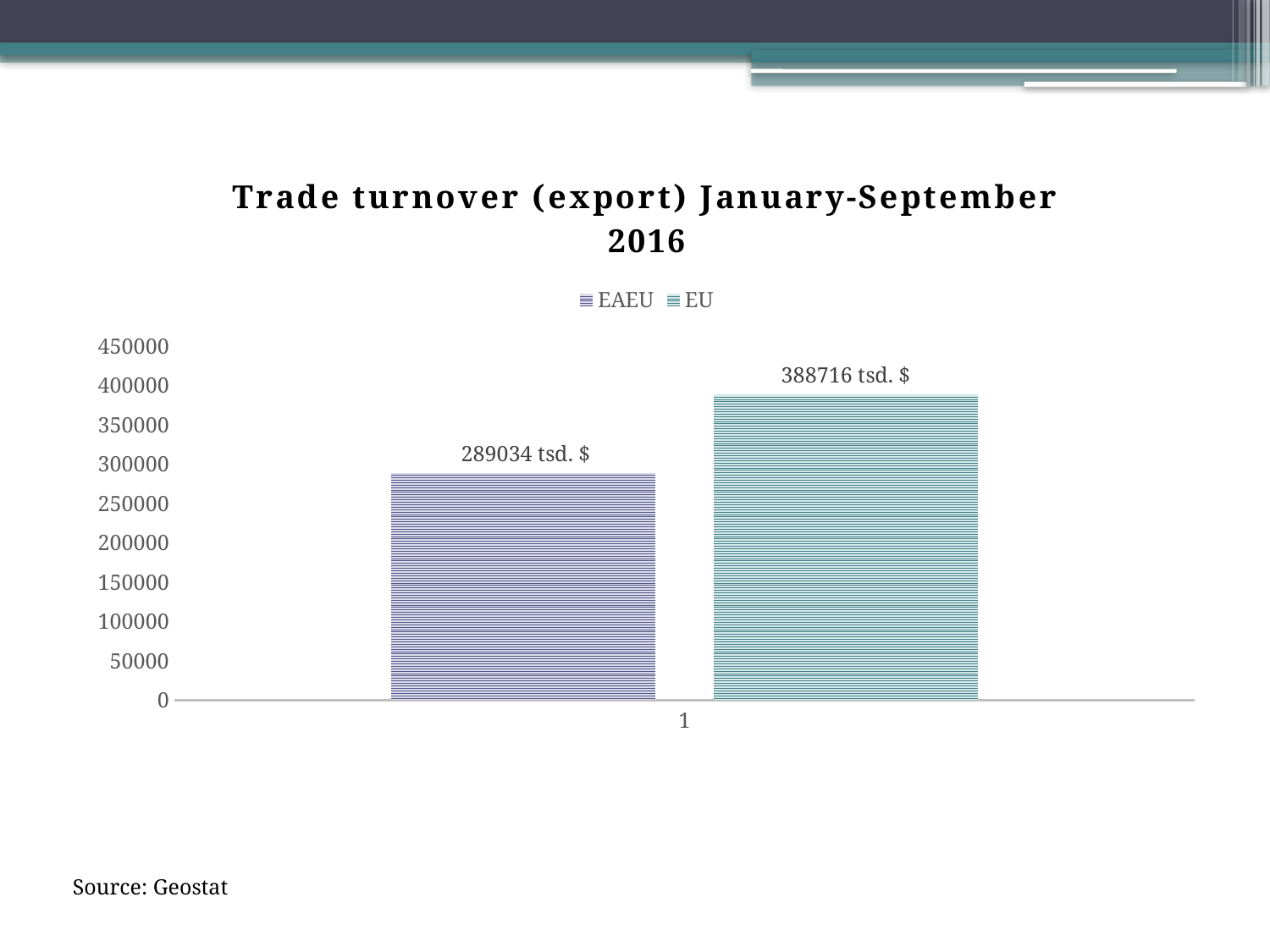
What is the export trade turnover value for EU? 388716 tsd. $ Is the value for EAEU greater or less than 300000? less What kind of chart is shown on the slide? bar chart What is the title of the chart? Trade turnover (export) January-September 2016 How many series does the legend list? 2 Which series has the highest value on the chart? EU Which series has the lowest value on the chart? EAEU What source is cited for the chart data? Geostat Which series has the higher export trade turnover, EAEU or EU? EU What is the difference between the EU and EAEU export values? 99682 tsd. $ What is the export trade turnover value for EAEU? 289034 tsd. $ Is the value for EU greater or less than 350000? greater